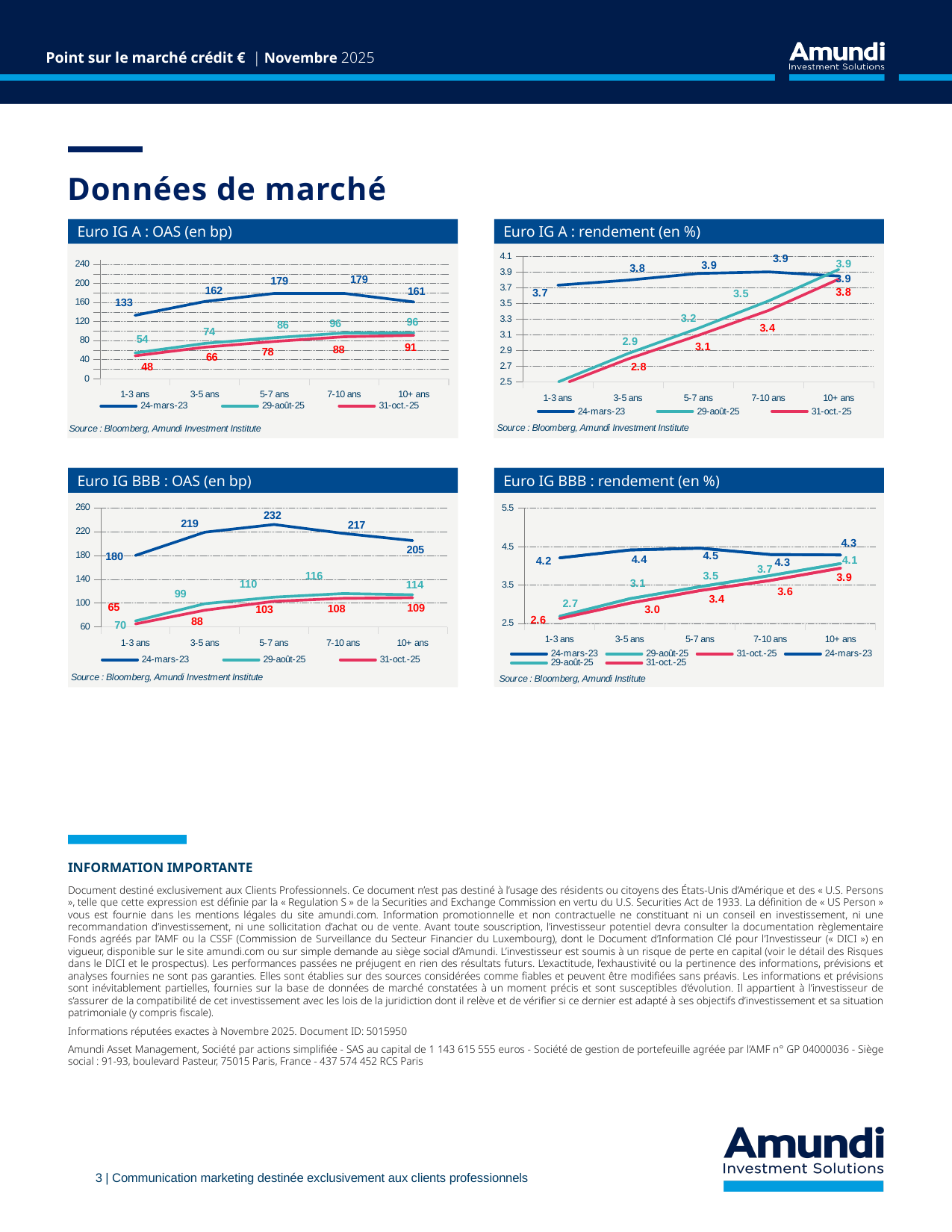
In the 'Euro IG BBB : OAS (en bp)' chart, which is larger at 10+ ans: 29-août-25 or 31-oct.-25? 29-août-25 In the 'Euro IG A : OAS (en bp)' chart, what is the difference between the 29-août-25 and 31-oct.-25 values at 3-5 ans? 8 In the 'Euro IG BBB : rendement (en %)' chart, what is the difference between the 24-mars-23 and 29-août-25 values at 10+ ans? 0.2 In the 'Euro IG A : rendement (en %)' chart, does the 29-août-25 series rise or fall from 3-5 ans to 10+ ans? rise In the 'Euro IG A : OAS (en bp)' chart, what is the value for 31-oct.-25 at 1-3 ans? 48 In the 'Euro IG BBB : OAS (en bp)' chart, which maturity has the highest value for 29-août-25? 7-10 ans In the 'Euro IG BBB : rendement (en %)' chart, what is the value for 31-oct.-25 at 1-3 ans? 2.6 In the 'Euro IG A : rendement (en %)' chart, what is the value for 31-oct.-25 at 7-10 ans? 3.4 In the 'Euro IG A : OAS (en bp)' chart, what is the value for 24-mars-23 at 5-7 ans? 179 In the 'Euro IG A : OAS (en bp)' chart, which maturity has the lowest value for 24-mars-23? 1-3 ans In the 'Euro IG BBB : OAS (en bp)' chart, what is the value for 24-mars-23 at 5-7 ans? 232 How many maturity categories are shown on the x axis of the 'Euro IG A : OAS (en bp)' chart? 5